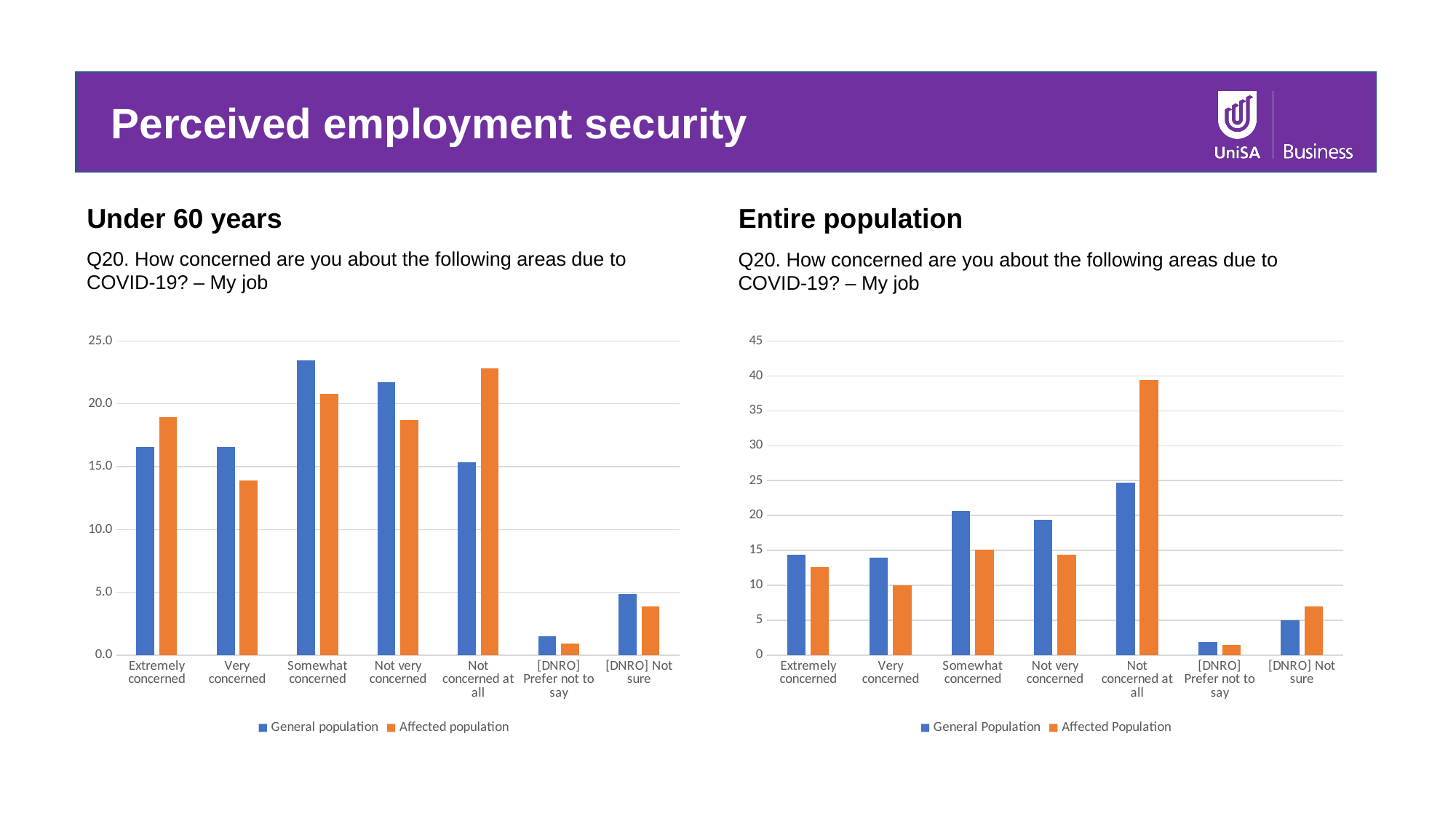
On the 'Under 60 years' chart, for 'Extremely concerned', which series has the larger value: General population or Affected population? Affected population What type of chart is the 'Entire population' chart? bar chart On the 'Entire population' chart, which category has the lowest General Population value? [DNRO] Prefer not to say How many categories are shown on the x axis of the 'Under 60 years' chart? 7 On the 'Entire population' chart, which category has the highest Affected Population value? Not concerned at all On the 'Under 60 years' chart, is the General population value for 'Somewhat concerned' greater or less than 20.0? greater On the 'Entire population' chart, is the Affected Population value for 'Not concerned at all' greater or less than 35? greater On the 'Under 60 years' chart, which category has the highest Affected population value? Not concerned at all On the 'Under 60 years' chart, is the Affected population value for 'Not concerned at all' greater or less than 20.0? greater On the 'Under 60 years' chart, which category has the highest General population value? Somewhat concerned How many series does the legend of the 'Entire population' chart list? 2 On the 'Entire population' chart, for 'Very concerned', which series has the larger value: General Population or Affected Population? General Population